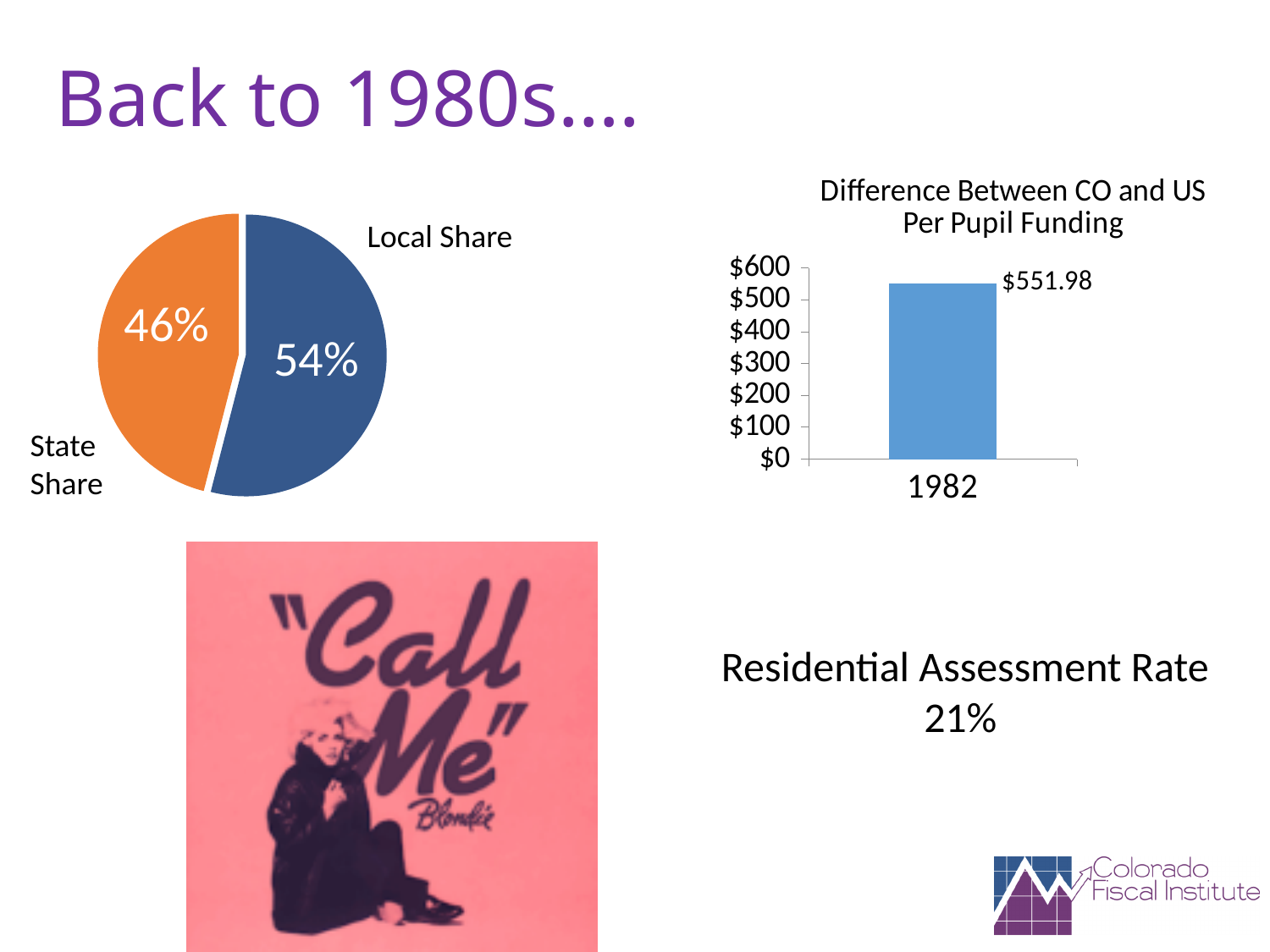
In the pie chart on the left, what colour is the State Share slice? Orange In the chart titled 'Difference Between CO and US Per Pupil Funding', what is the value for 1982? $551.98 What kind of chart is the chart on the left of the slide? Pie chart In the pie chart on the left, what share is labelled Local Share? 54% How many bars are in the chart titled 'Difference Between CO and US Per Pupil Funding'? 1 In the pie chart on the left, which slice is larger, Local Share or State Share? Local Share In the pie chart on the left, what is the difference in percentage points between Local Share and State Share? 8 What is the title of the bar chart on the right of the slide? Difference Between CO and US Per Pupil Funding In the chart titled 'Difference Between CO and US Per Pupil Funding', is the value for 1982 greater or less than $500? greater How many slices does the pie chart on the left have? 2 In the pie chart on the left, what share is labelled State Share? 46% What kind of chart is the chart titled 'Difference Between CO and US Per Pupil Funding'? Bar chart